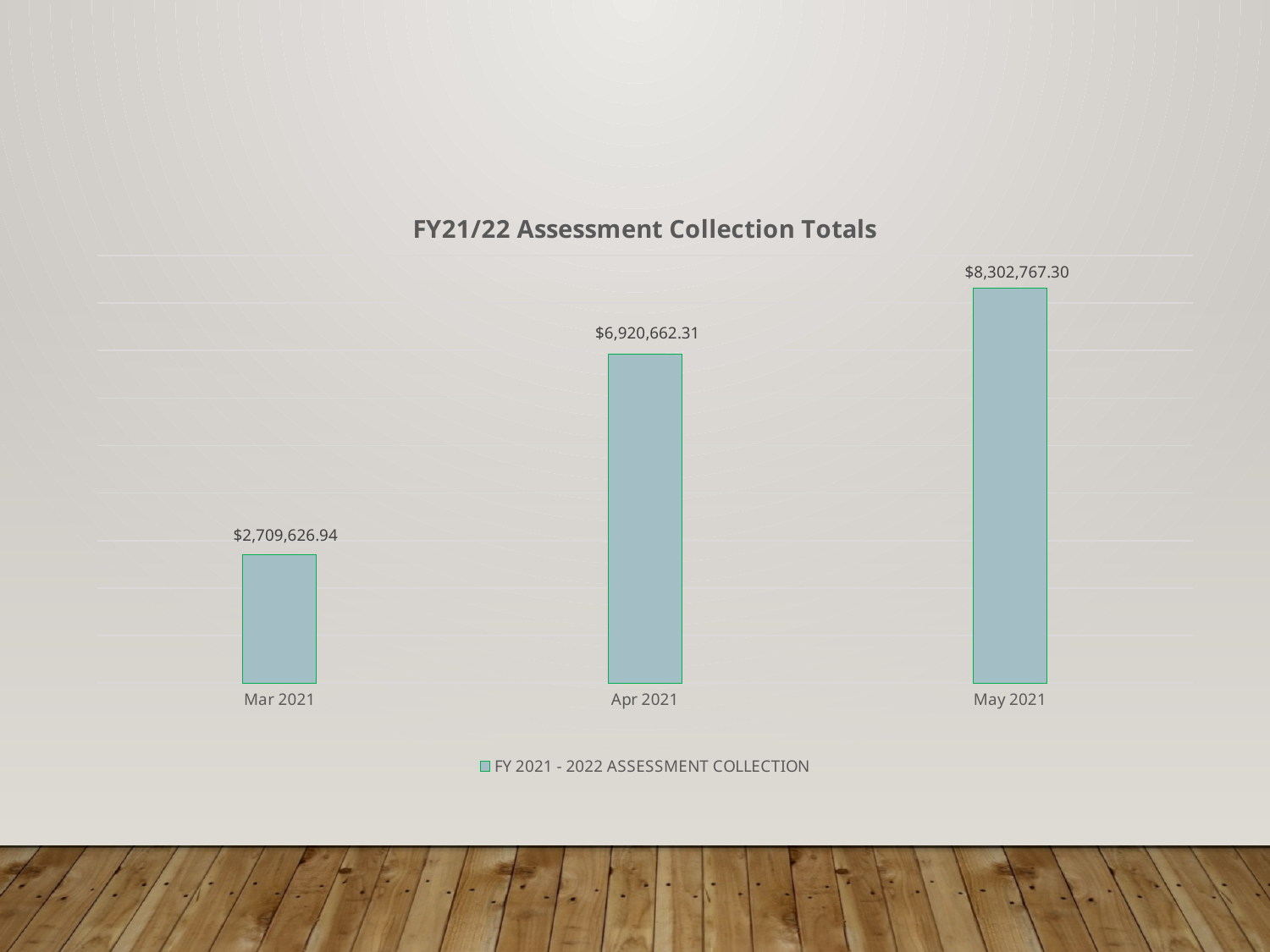
What kind of chart is shown on the slide? Bar chart What is the difference between the Apr 2021 and Mar 2021 values? $4,211,035.37 Which month has the highest assessment collection total? May 2021 What is the value for Mar 2021? $2,709,626.94 What is the difference between the May 2021 and Apr 2021 values? $1,382,104.99 What is the value for May 2021? $8,302,767.30 How many months are shown on the x axis? 3 Which month has the lowest assessment collection total? Mar 2021 Which is larger, the value for Apr 2021 or the value for Mar 2021? Apr 2021 Do the values rise or fall from Mar 2021 to May 2021? Rise What is the value for Apr 2021? $6,920,662.31 How many series does the legend list? 1